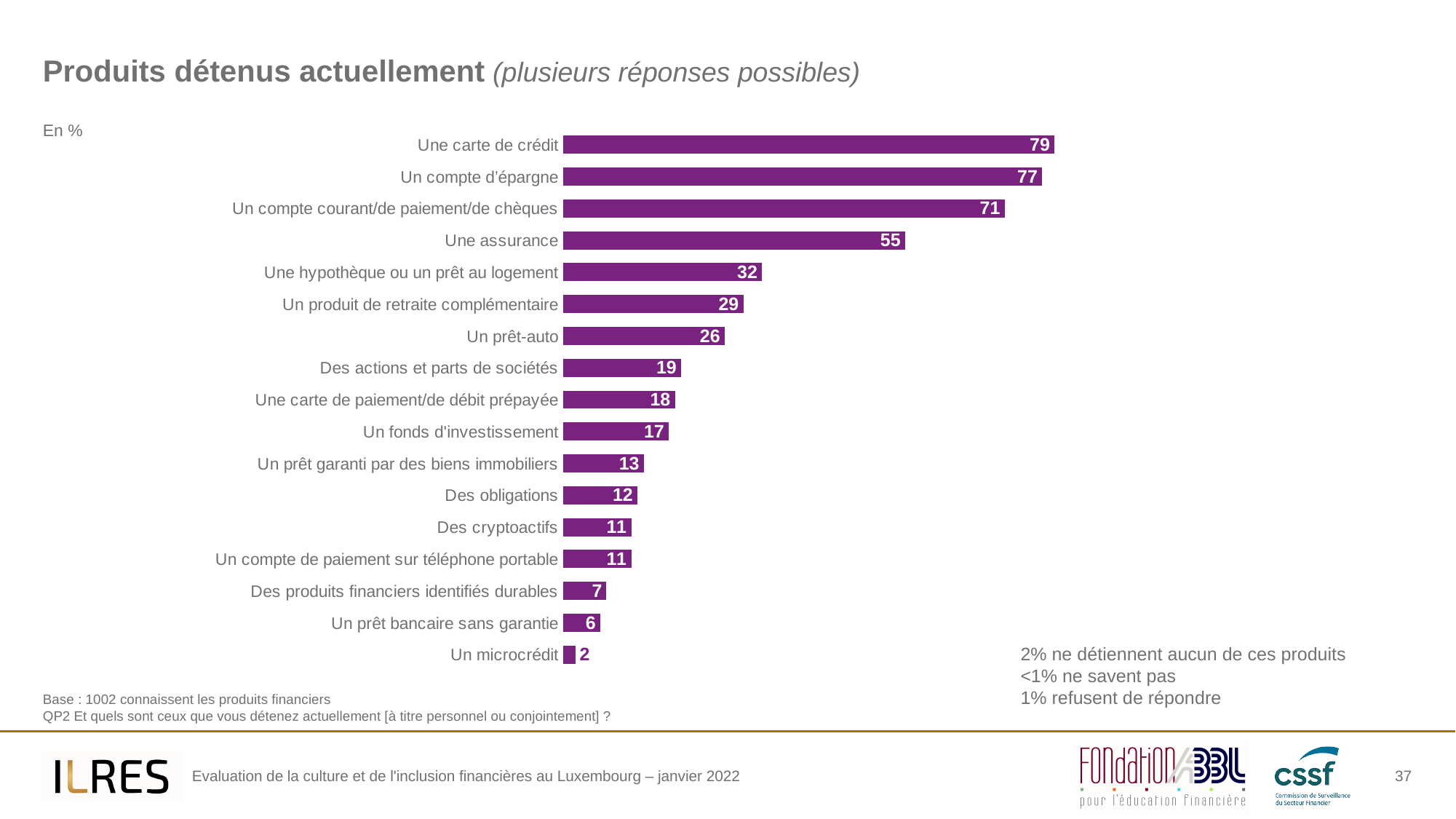
Which is larger, the value for "Des actions et parts de sociétés" or the value for "Un fonds d'investissement"? Des actions et parts de sociétés What is the value for "Une assurance"? 55 What is the difference between the values for "Une hypothèque ou un prêt au logement" and "Un prêt-auto"? 6 Which is larger, the value for "Des obligations" or the value for "Un prêt garanti par des biens immobiliers"? Un prêt garanti par des biens immobiliers What is the difference between the values for "Un compte d'épargne" and "Un compte courant/de paiement/de chèques"? 6 What is the value for "Des cryptoactifs"? 11 What is the value for "Une carte de crédit"? 79 How many categories are shown in the chart? 17 What kind of chart is shown on the slide? Bar chart Which category has the highest value? Une carte de crédit What is the title of the chart? Produits détenus actuellement (plusieurs réponses possibles) Which category has the lowest value? Un microcrédit